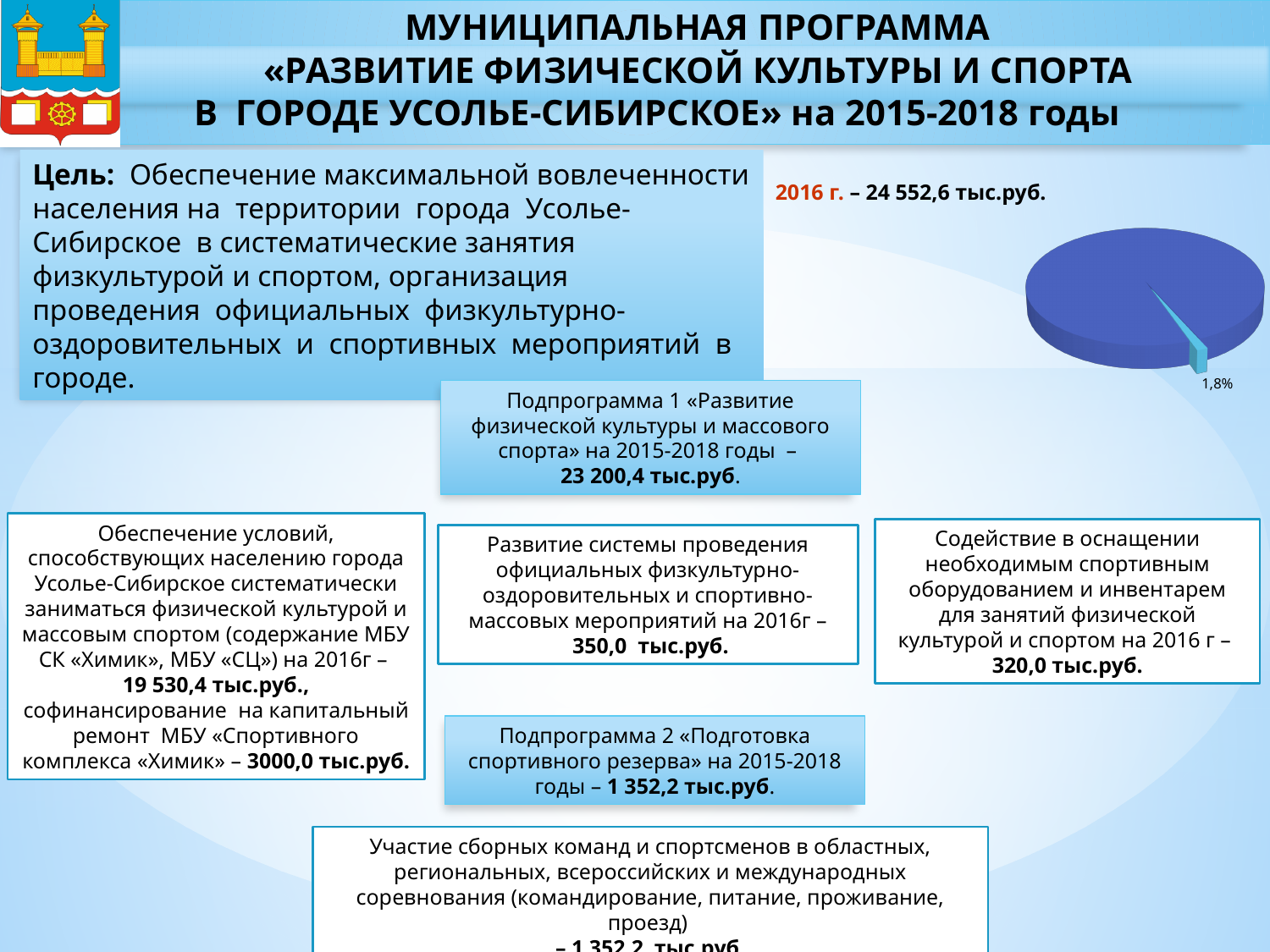
What kind of chart is shown on the slide? pie chart What percentage is printed on the small slice of the pie chart? 1,8% Which slice of the pie chart is larger, the blue slice or the slice labelled 1,8%? the blue slice What colour is the large slice of the pie chart? blue Is the share of the slice labelled on the pie chart greater or less than 10%? less How many slices of the pie chart have a percentage label printed? 1 How many slices does the pie chart have? 2